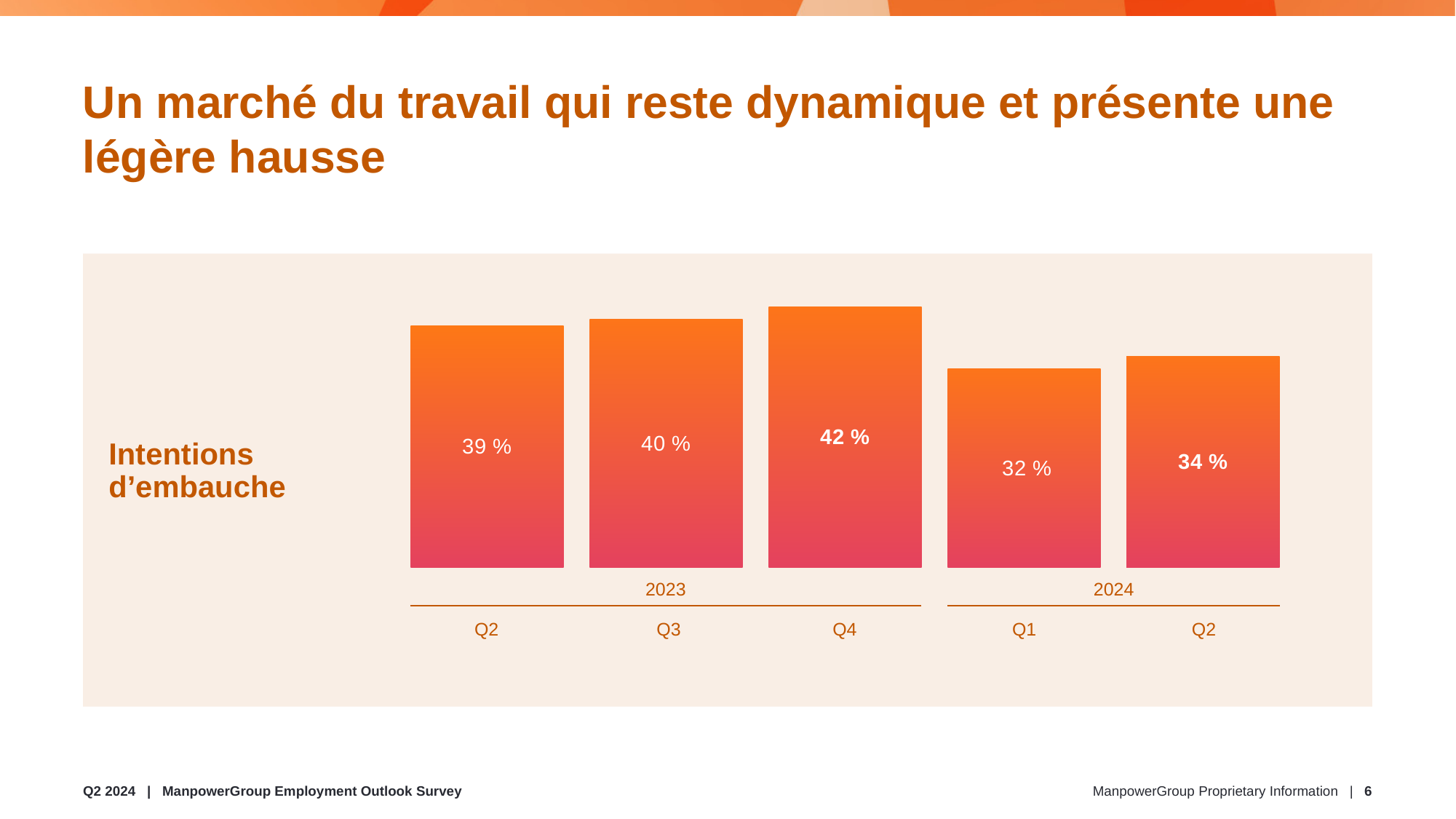
What is the value for Q2 2023? 39 % What is the value for Q1 2024? 32 % What kind of chart is shown? Bar chart Which quarter has the highest value? Q4 2023 Which is larger, Q3 2023 or Q2 2024? Q3 2023 What is the difference between Q4 2023 and Q1 2024? 10 % How many bars are shown in the chart? 5 What is the value for Q4 2023? 42 % Which quarter has the lowest value? Q1 2024 What is the difference between Q2 2024 and Q2 2023? 5 % What is the value for Q2 2024? 34 % What is the label to the left of the chart? Intentions d’embauche